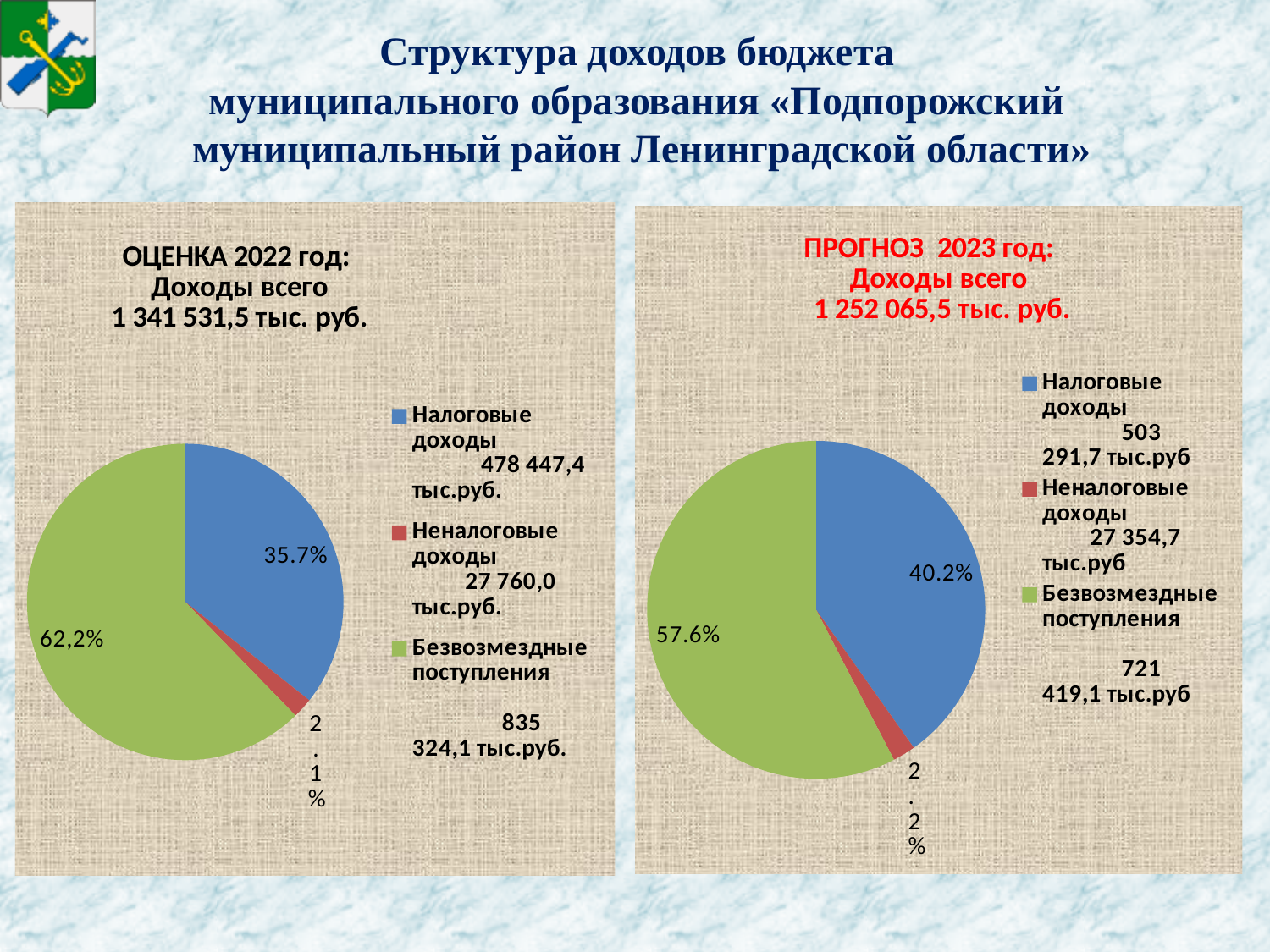
In the ПРОГНОЗ 2023 год pie chart, what share of the pie is Безвозмездные поступления? 57.6% In the ОЦЕНКА 2022 год pie chart, what share of the pie is Налоговые доходы? 35.7% In the ПРОГНОЗ 2023 год chart, what value does the legend give for Безвозмездные поступления? 721 419,1 тыс.руб In the ОЦЕНКА 2022 год chart, what value does the legend give for Налоговые доходы? 478 447,4 тыс.руб. In the ОЦЕНКА 2022 год chart, what value does the legend give for Неналоговые доходы? 27 760,0 тыс.руб. In the ОЦЕНКА 2022 год pie chart, what share of the pie is Неналоговые доходы? 2.1% How many categories does the legend of the ПРОГНОЗ 2023 год pie chart list? 3 In the ОЦЕНКА 2022 год pie chart, which category has the largest slice? Безвозмездные поступления In the ПРОГНОЗ 2023 год pie chart, which category has the smallest slice? Неналоговые доходы What kind of chart is used on the left (ОЦЕНКА 2022 год) panel of the slide? pie chart